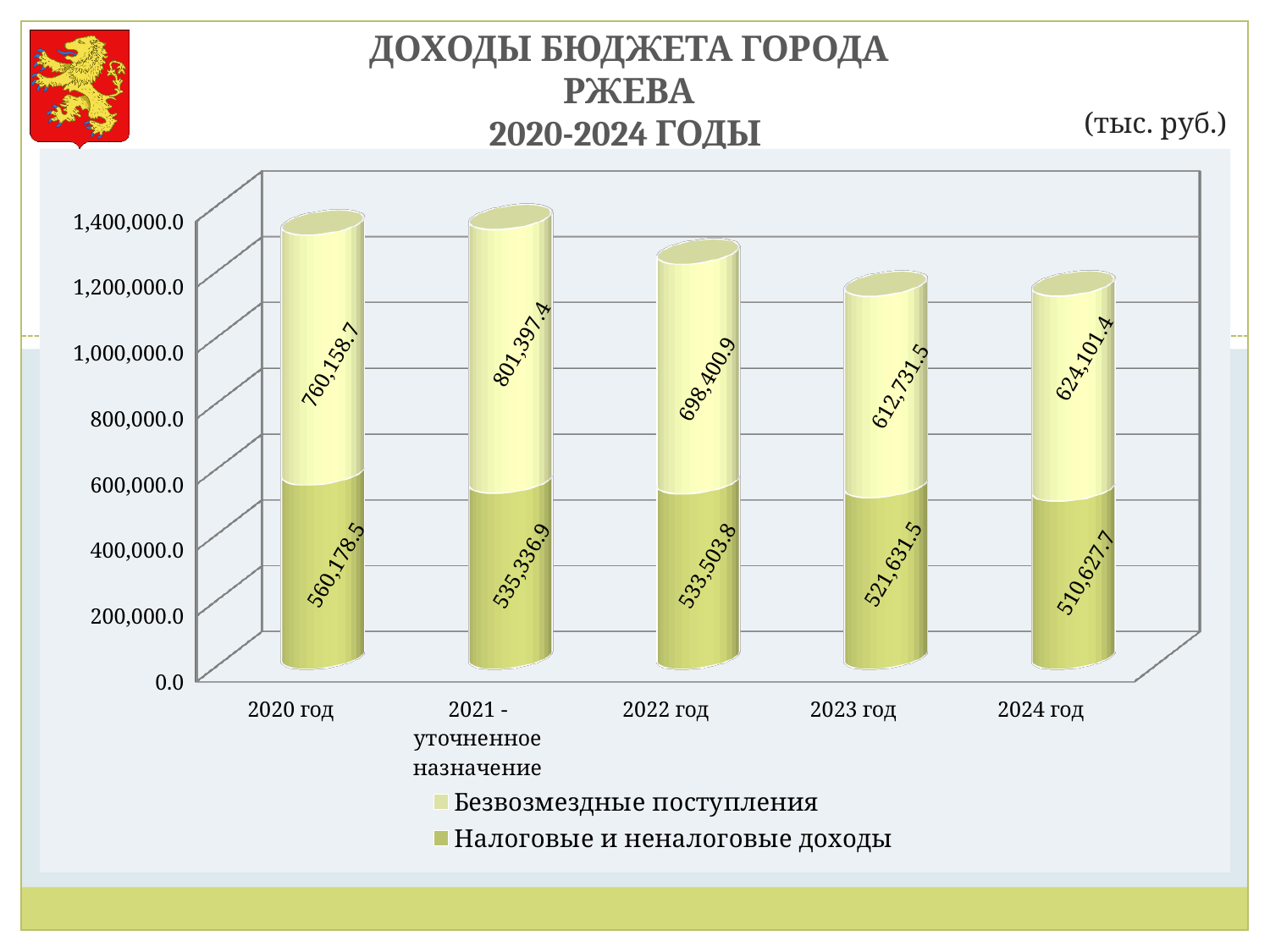
How many categories (years) are shown on the x axis? 5 What type of chart is shown on the slide? Stacked bar chart Which is larger: Безвозмездные поступления in 2023 год or in 2024 год? 2024 год How many series does the legend list? 2 What is the total of the stacked bar for 2023 год? 1,134,363.0 What is the value of Безвозмездные поступления for 2022 год? 698,400.9 What is the value of Безвозмездные поступления for 2020 год? 760,158.7 In which year is the value of Безвозмездные поступления the highest? 2021 - уточненное назначение What is the value of Налоговые и неналоговые доходы for 2024 год? 510,627.7 In which year is the value of Налоговые и неналоговые доходы the lowest? 2024 год Do the values of Налоговые и неналоговые доходы rise or fall from 2020 to 2024? Fall What is the difference between Безвозмездные поступления and Налоговые и неналоговые доходы in 2020 год? 199,980.2